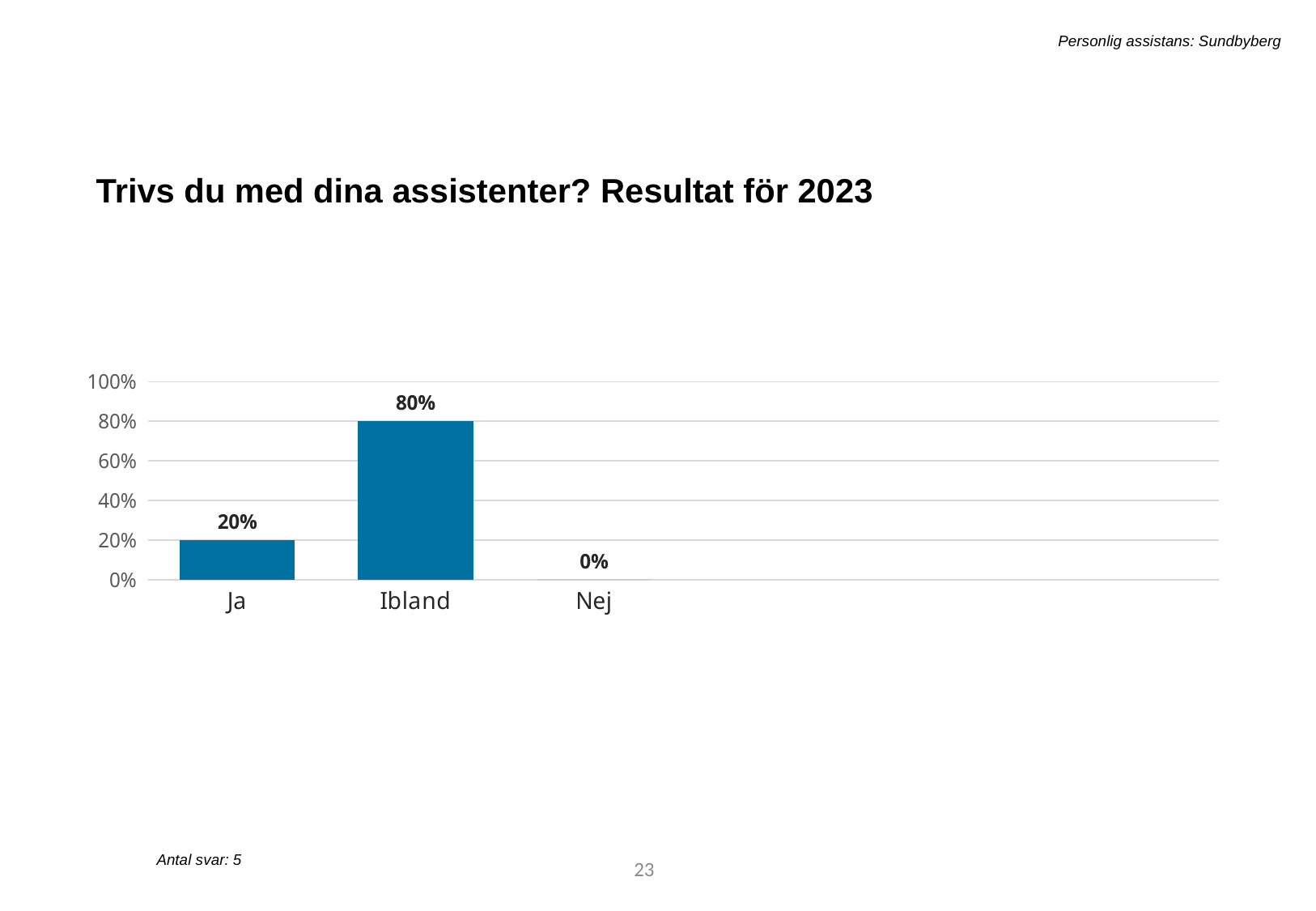
Which category has the lowest value? Nej What is the value for Ja? 20% What is the difference between the values for Ibland and Ja? 60% How many categories are shown on the x axis? 3 Is the value for Ibland greater or less than 60%? greater What is the value for Nej? 0% What is the title of the slide? Trivs du med dina assistenter? Resultat för 2023 What is the value for Ibland? 80% What kind of chart is shown on the slide? bar chart Which is larger, the value for Ja or the value for Ibland? Ibland Which category has the highest value? Ibland How many responses (Antal svar) does the slide report? 5